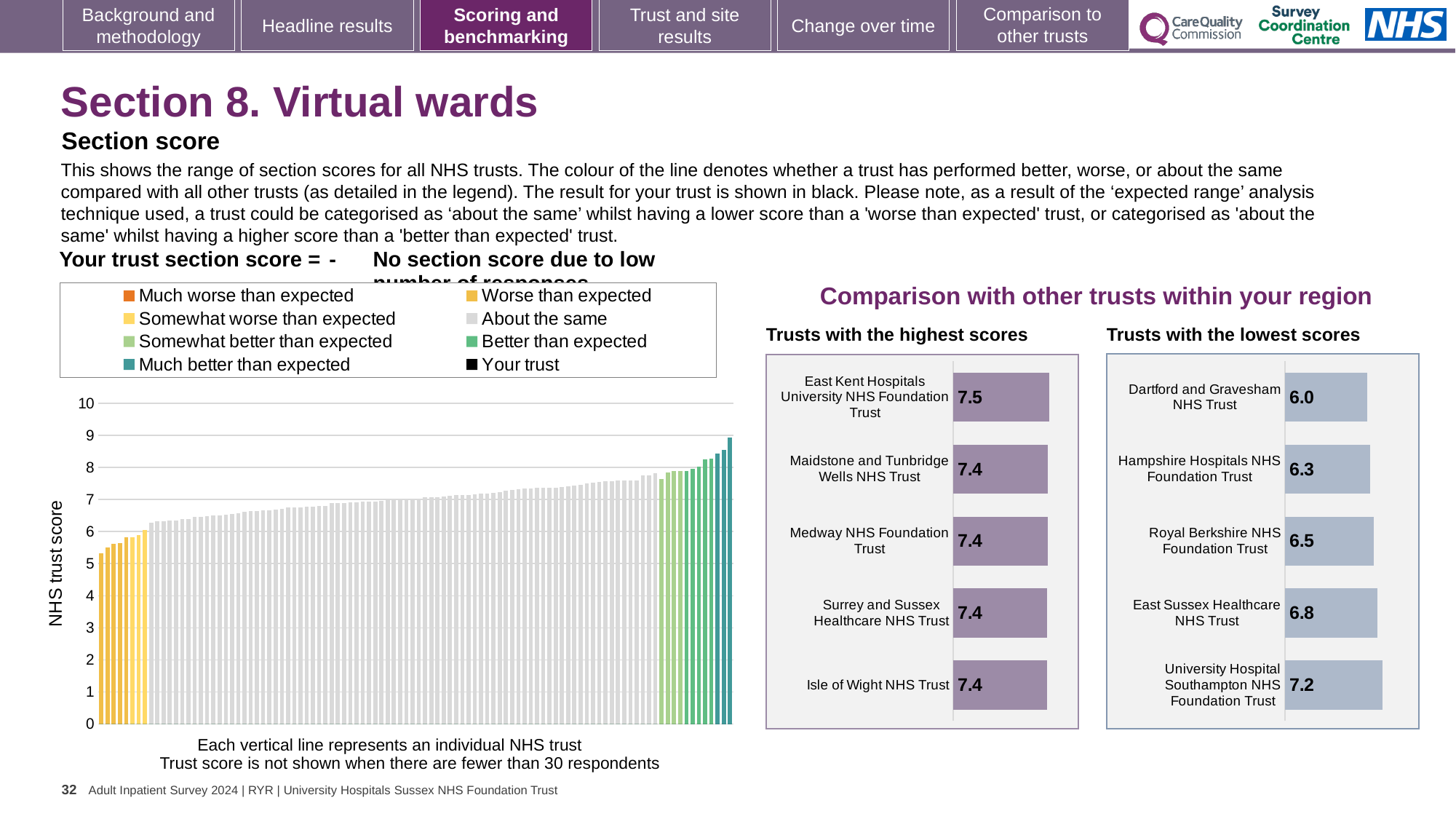
How many trusts are shown in the 'Trusts with the highest scores' chart? 5 In the 'Trusts with the highest scores' chart, what is the score for Isle of Wight NHS Trust? 7.4 In the 'Trusts with the highest scores' chart, what is the score for East Kent Hospitals University NHS Foundation Trust? 7.5 In the 'Trusts with the lowest scores' chart, which trust has the highest score? University Hospital Southampton NHS Foundation Trust In the 'Trusts with the lowest scores' chart, which has the larger score: Hampshire Hospitals NHS Foundation Trust or University Hospital Southampton NHS Foundation Trust? University Hospital Southampton NHS Foundation Trust How many entries does the legend of the NHS trust score chart on the left list? 8 In the 'Trusts with the lowest scores' chart, which trust has the lowest score? Dartford and Gravesham NHS Trust In the 'Trusts with the lowest scores' chart, what is the score for Royal Berkshire NHS Foundation Trust? 6.5 In the 'Trusts with the highest scores' chart, which trust has the highest score? East Kent Hospitals University NHS Foundation Trust In the NHS trust score chart on the left, is the value of the tallest bar greater or less than 8? greater In the 'Trusts with the lowest scores' chart, what is the difference between the scores of East Sussex Healthcare NHS Trust and Hampshire Hospitals NHS Foundation Trust? 0.5 In the 'Trusts with the lowest scores' chart, what is the score for Dartford and Gravesham NHS Trust? 6.0